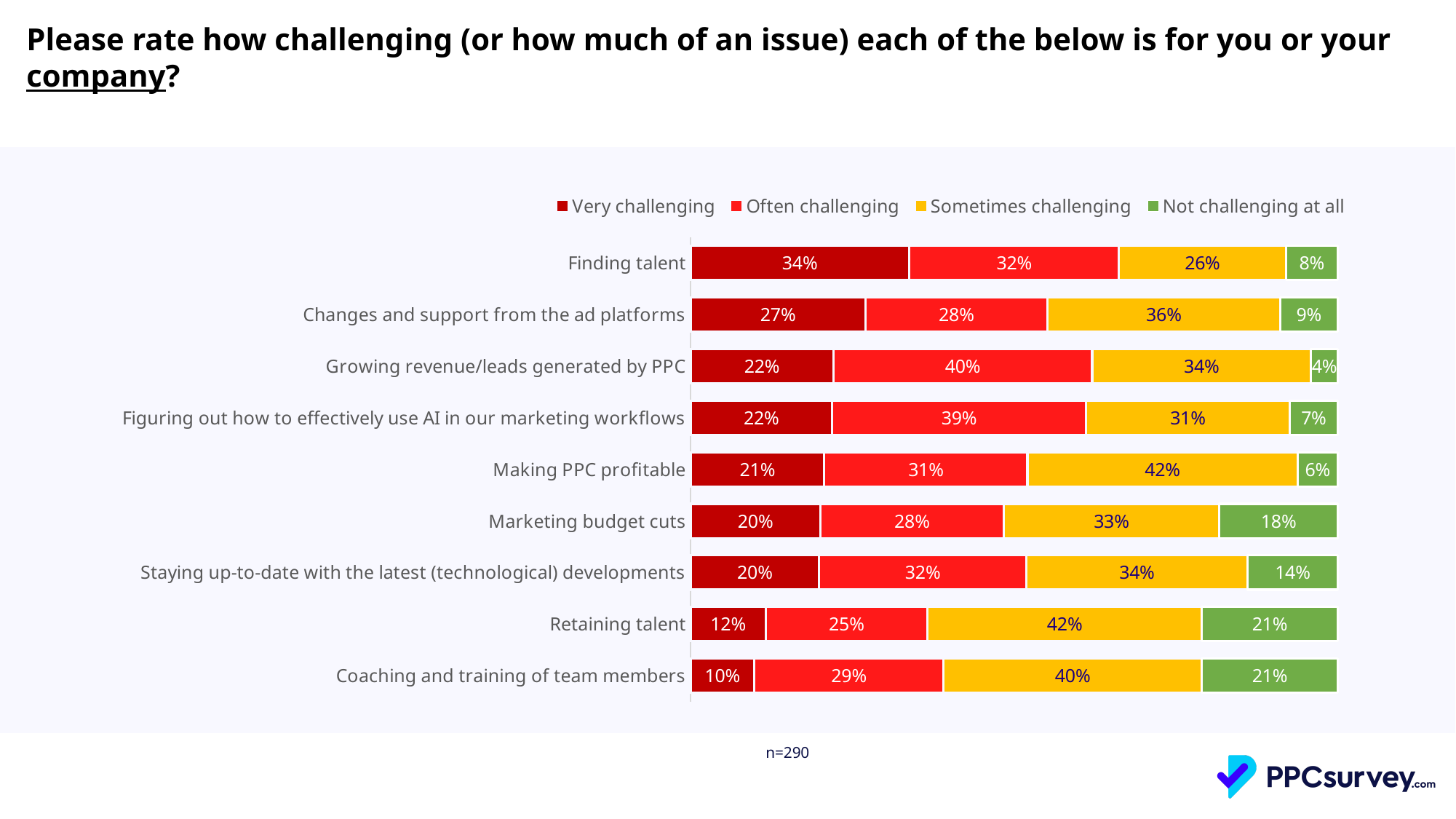
Which category has the highest Often challenging percentage? Growing revenue/leads generated by PPC Which is larger: the Not challenging at all percentage for 'Marketing budget cuts' or for 'Staying up-to-date with the latest (technological) developments'? Marketing budget cuts What kind of chart is shown on the slide? Stacked bar chart What is the sample size noted below the chart? n=290 What percentage of respondents rated 'Making PPC profitable' as Sometimes challenging? 42% What percentage of respondents rated 'Marketing budget cuts' as Not challenging at all? 18% Which category has the lowest Very challenging percentage? Coaching and training of team members How many series does the legend list? 4 How many categories are shown in the chart? 9 What percentage of respondents rated 'Finding talent' as Very challenging? 34% Which category has the highest Very challenging percentage? Finding talent What is the difference between the Very challenging percentages for 'Finding talent' and 'Retaining talent'? 22%